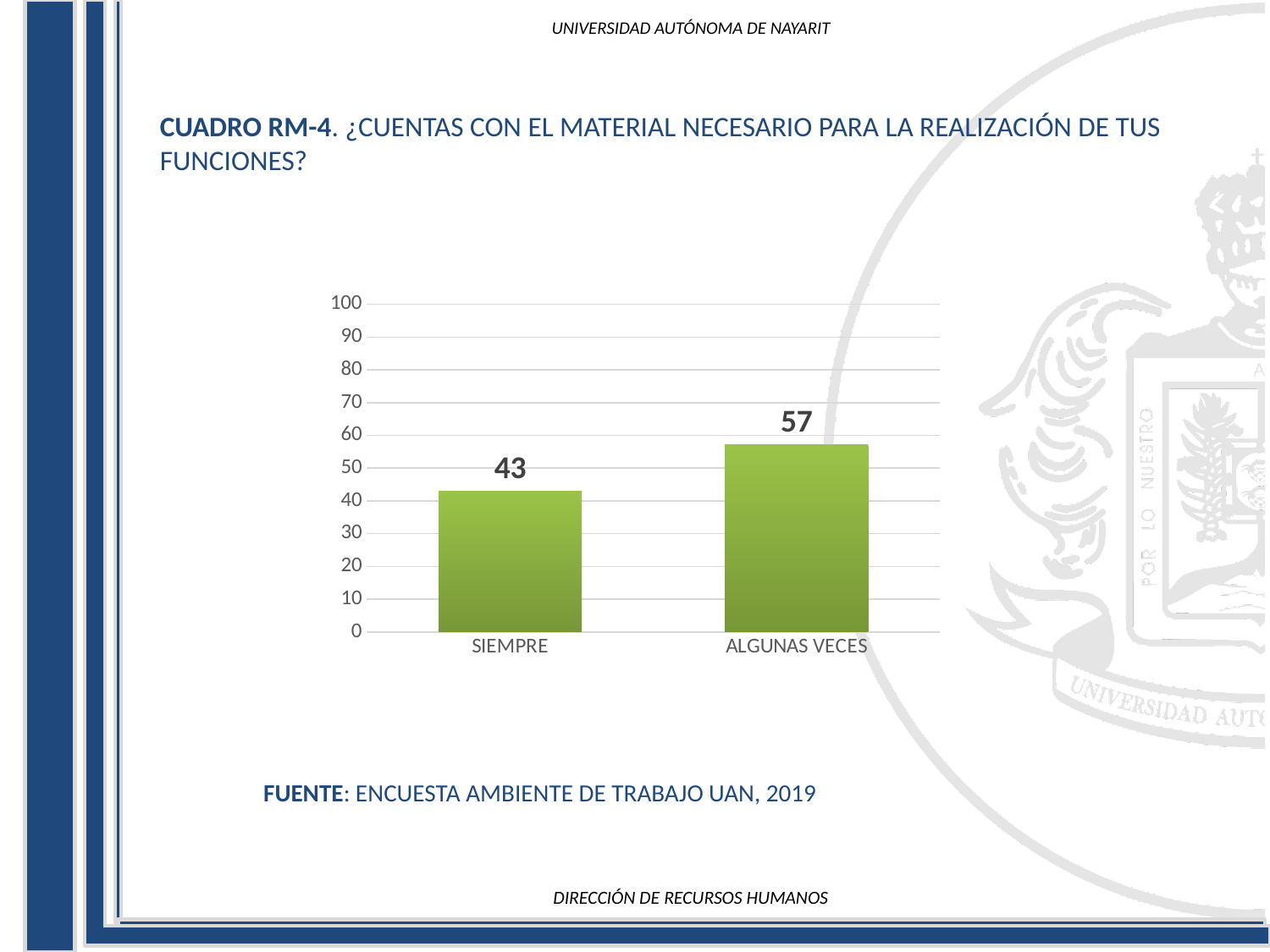
What colour are the bars in the chart? green Which category has the lowest value? SIEMPRE Which is larger, the value for SIEMPRE or the value for ALGUNAS VECES? ALGUNAS VECES What kind of chart is shown on the slide? bar chart What is the value for SIEMPRE? 43 Is the value for SIEMPRE greater or less than 50? less What is the value for ALGUNAS VECES? 57 How many categories are shown on the x axis? 2 Is the value for ALGUNAS VECES greater or less than 50? greater What is the maximum value shown on the y axis? 100 Which category has the highest value? ALGUNAS VECES What is the difference between the values for ALGUNAS VECES and SIEMPRE? 14